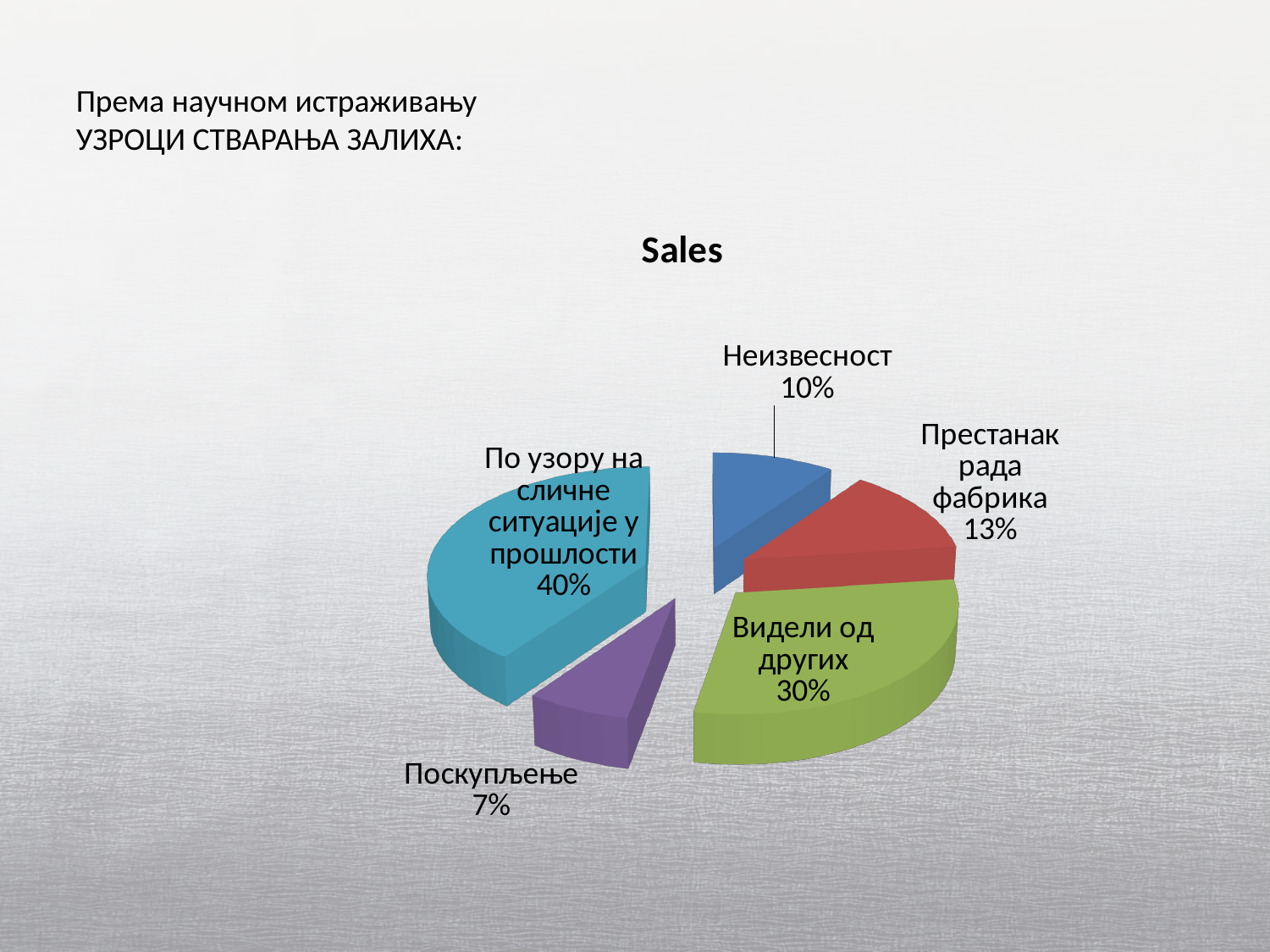
Which is larger, the share for Неизвесност or the share for Престанак рада фабрика? Престанак рада фабрика Which slice of the pie is the largest? По узору на сличне ситуације у прошлости How many slices does the pie chart have? 5 What share does the slice labelled Неизвесност have? 10% What type of chart is shown on the slide? Pie chart What is the title of the chart? Sales What share does the slice labelled По узору на сличне ситуације у прошлости have? 40% What is the difference between the shares of Видели од других and Престанак рада фабрика? 17% What share does the slice labelled Поскупљење have? 7% What share does the slice labelled Престанак рада фабрика have? 13% Which slice of the pie is the smallest? Поскупљење What share does the slice labelled Видели од других have? 30%